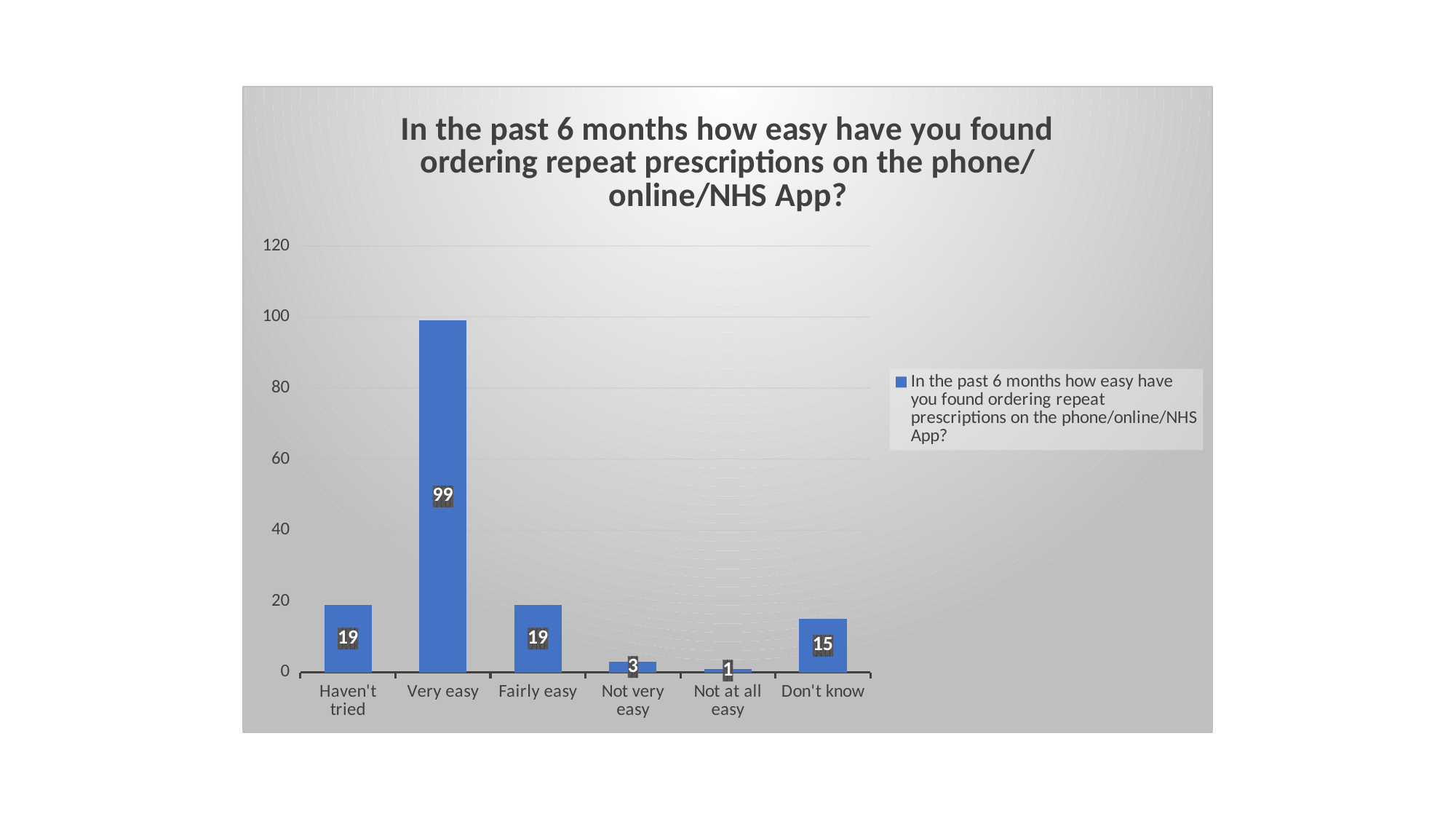
What is the difference between the values for "Very easy" and "Fairly easy"? 80 What is the value for "Haven't tried"? 19 How many series does the legend list? 1 What is the value for "Don't know"? 15 Which is larger, the value for "Don't know" or the value for "Fairly easy"? Fairly easy How many categories are shown on the x axis? 6 What kind of chart is shown on the slide? Bar chart Which category has the lowest value? Not at all easy Which category has the highest value? Very easy What is the value for "Not very easy"? 3 What is the value for "Very easy"? 99 What is the difference between the values for "Don't know" and "Not very easy"? 12